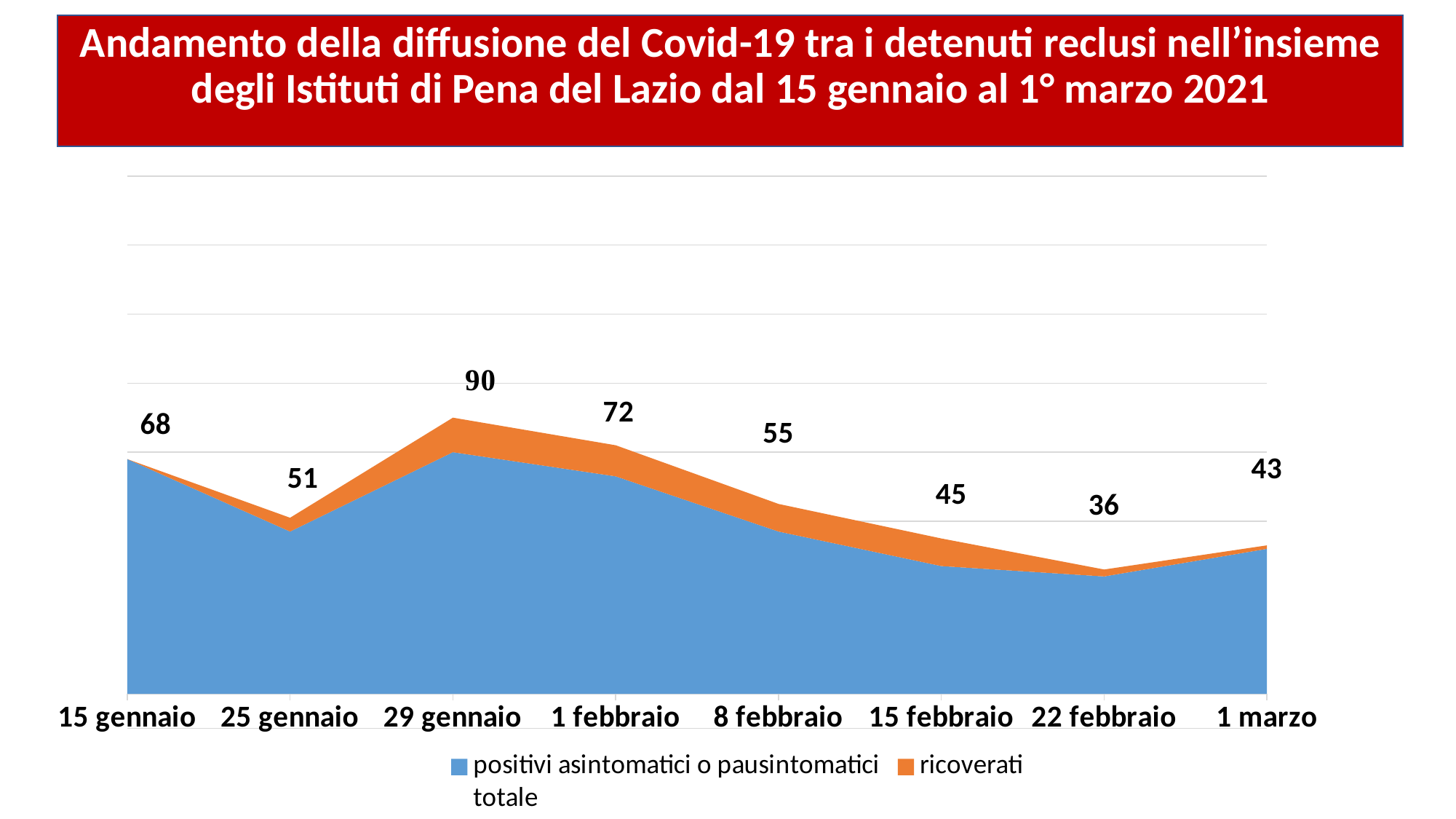
How many dates are shown on the x axis? 8 What is the labelled value for 15 gennaio? 68 What kind of chart is shown on the slide? Area chart What is the difference between the labelled values for 29 gennaio and 25 gennaio? 39 Which date has the highest labelled value? 29 gennaio What is the labelled value for 8 febbraio? 55 What is the difference between the labelled values for 1 febbraio and 15 febbraio? 27 What is the labelled value for 1 marzo? 43 Which date has the lowest labelled value? 22 febbraio What is the labelled value for 29 gennaio? 90 Which is larger, the labelled value for 25 gennaio or for 1 marzo? 25 gennaio Do the labelled values rise or fall from 29 gennaio to 22 febbraio? Fall